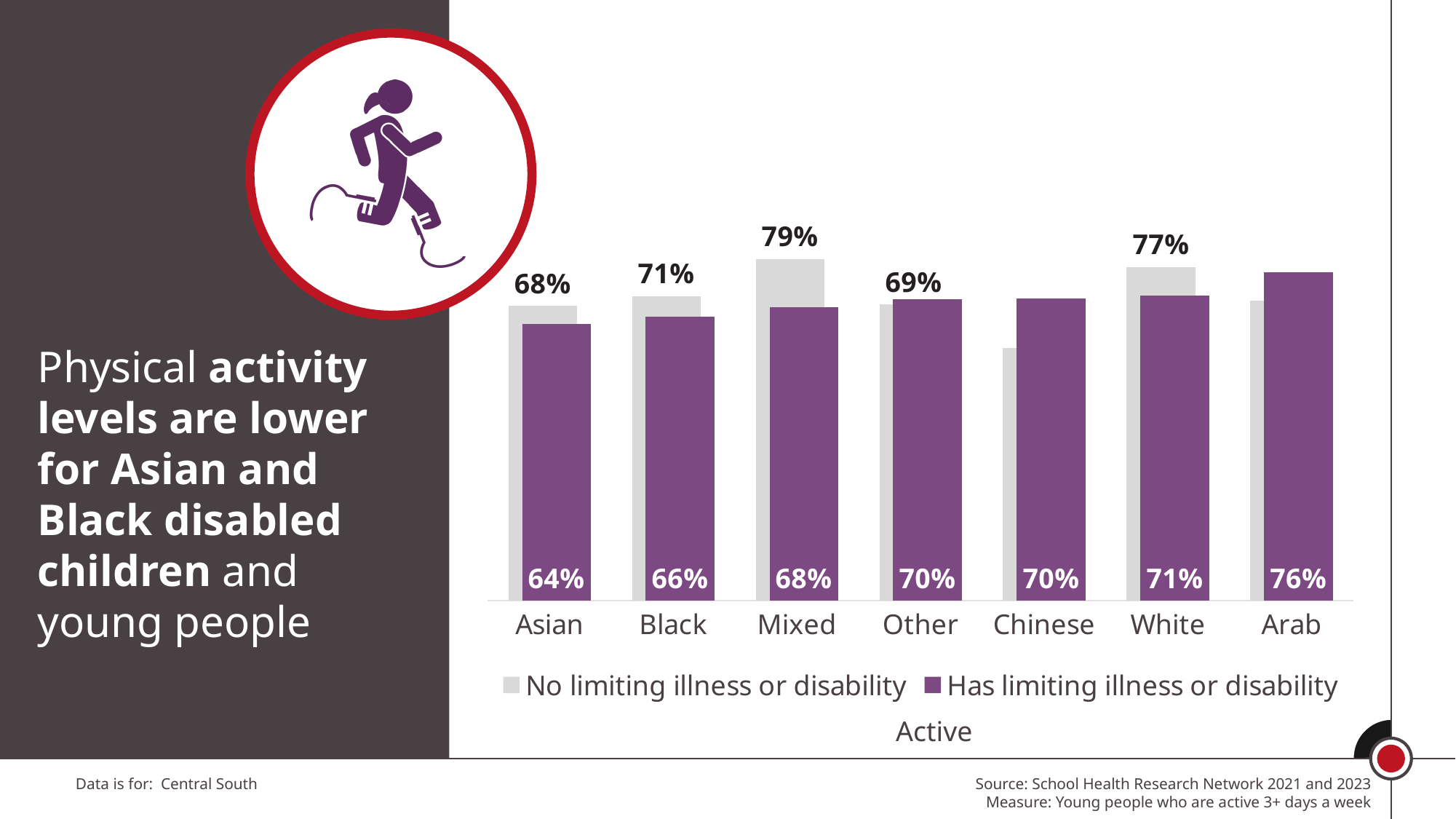
Which category has the lowest value in the 'Has limiting illness or disability' series? Asian What is the value for White in the 'No limiting illness or disability' series? 77% What kind of chart is shown on the slide? Bar chart Which category has the highest value in the 'Has limiting illness or disability' series? Arab What is the value for Asian in the 'Has limiting illness or disability' series? 64% For Asian, what is the difference between the 'No limiting illness or disability' value and the 'Has limiting illness or disability' value? 4 percentage points Which category has the highest value in the 'No limiting illness or disability' series? Mixed What is the value for Mixed in the 'No limiting illness or disability' series? 79% For Black, which is larger: the 'No limiting illness or disability' value or the 'Has limiting illness or disability' value? No limiting illness or disability How many ethnic group categories are shown on the x axis? 7 How many series does the legend list? 2 For Mixed, what is the difference between the 'No limiting illness or disability' value and the 'Has limiting illness or disability' value? 11 percentage points